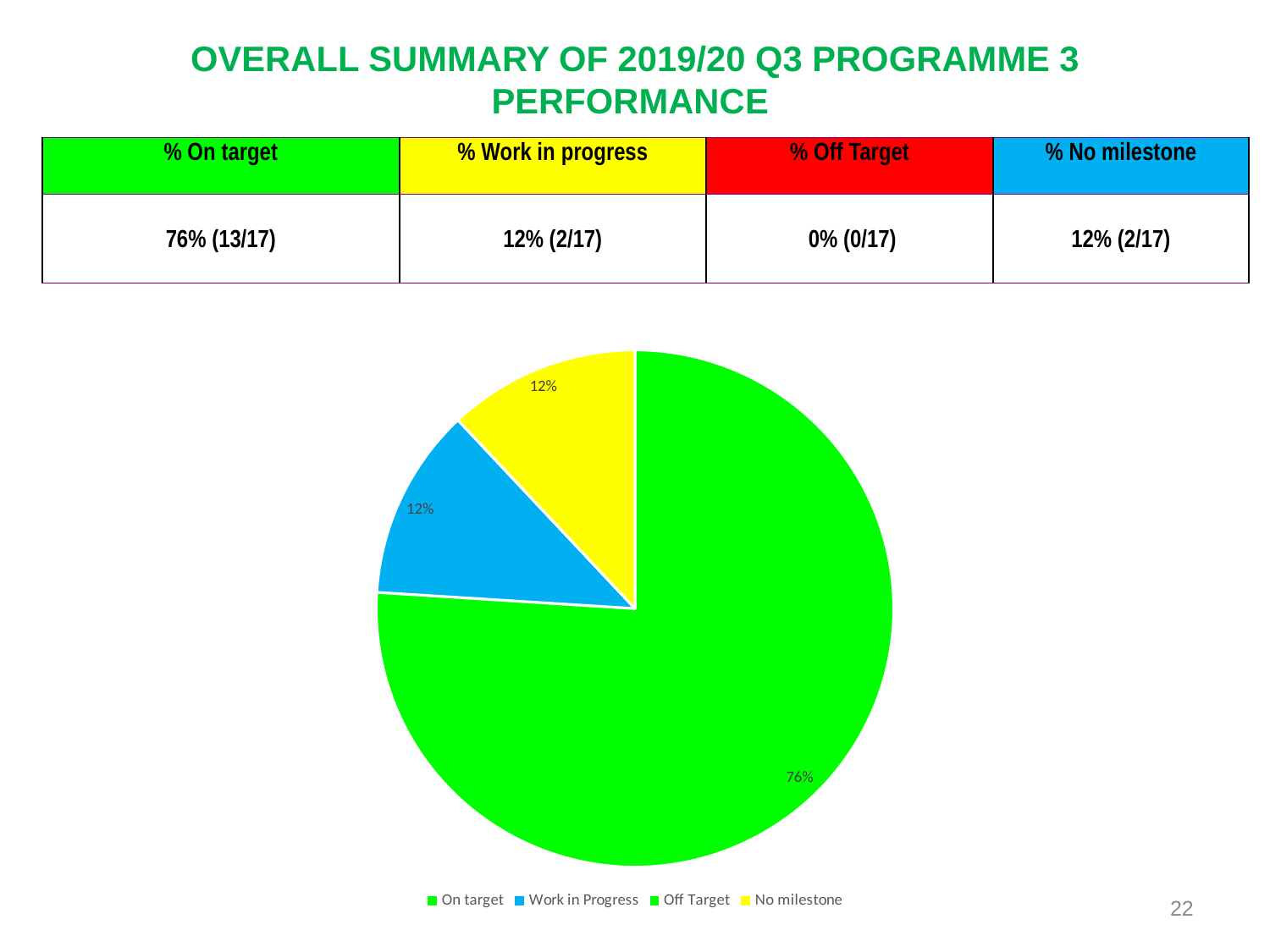
Which slice is larger, On target or No milestone? On target What is the difference in percentage points between the On target slice and the Work in Progress slice? 64 What kind of chart is shown on the slide? pie chart Which legend entry has no visible slice in the pie chart? Off Target Which category has the largest slice of the pie? On target How many slices are visible in the pie chart? 3 What share of the pie does the On target slice represent? 76% How many entries does the pie chart's legend list? 4 What percentage of the pie is labelled for No milestone? 12% What colour is the No milestone slice in the pie chart? yellow What percentage of the pie is labelled for On target? 76% What percentage of the pie is labelled for Work in Progress? 12%